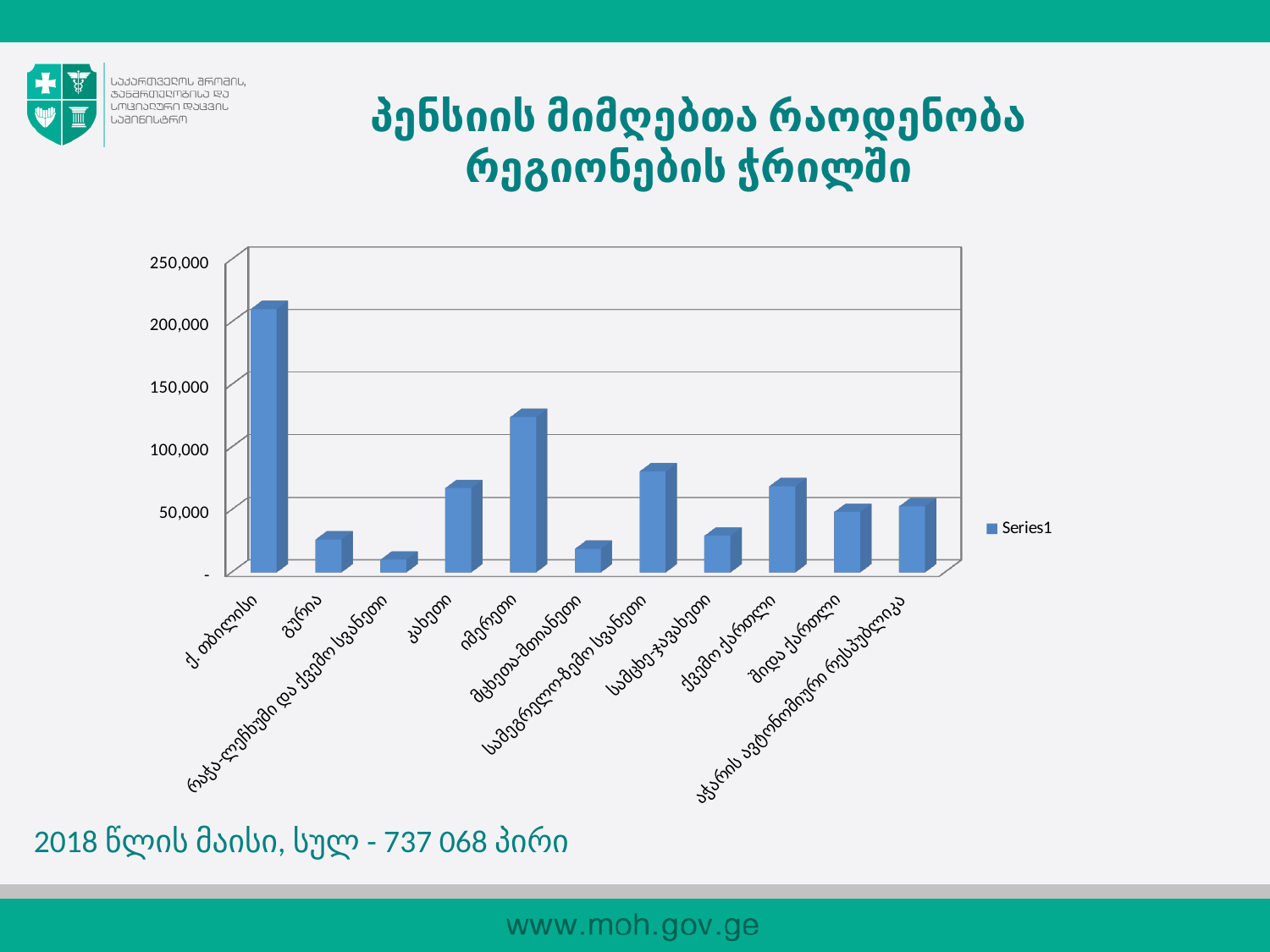
Which region has the highest number of pension recipients? ქ. თბილისი What kind of chart is shown on the slide? bar chart Which has a larger value, იმერეთი or კახეთი? იმერეთი Is the value for სამეგრელო-ზემო სვანეთი greater or less than 50,000? greater Is the value for ქ. თბილისი greater or less than 150,000? greater Is the value for იმერეთი greater or less than 100,000? greater How many series does the legend list? 1 What is the name of the series shown in the legend? Series1 How many regions (categories) are plotted on the chart? 11 Which has a larger value, გურია or მცხეთა-მთიანეთი? გურია Which region has the lowest number of pension recipients? რაჭა-ლეჩხუმი და ქვემო სვანეთი